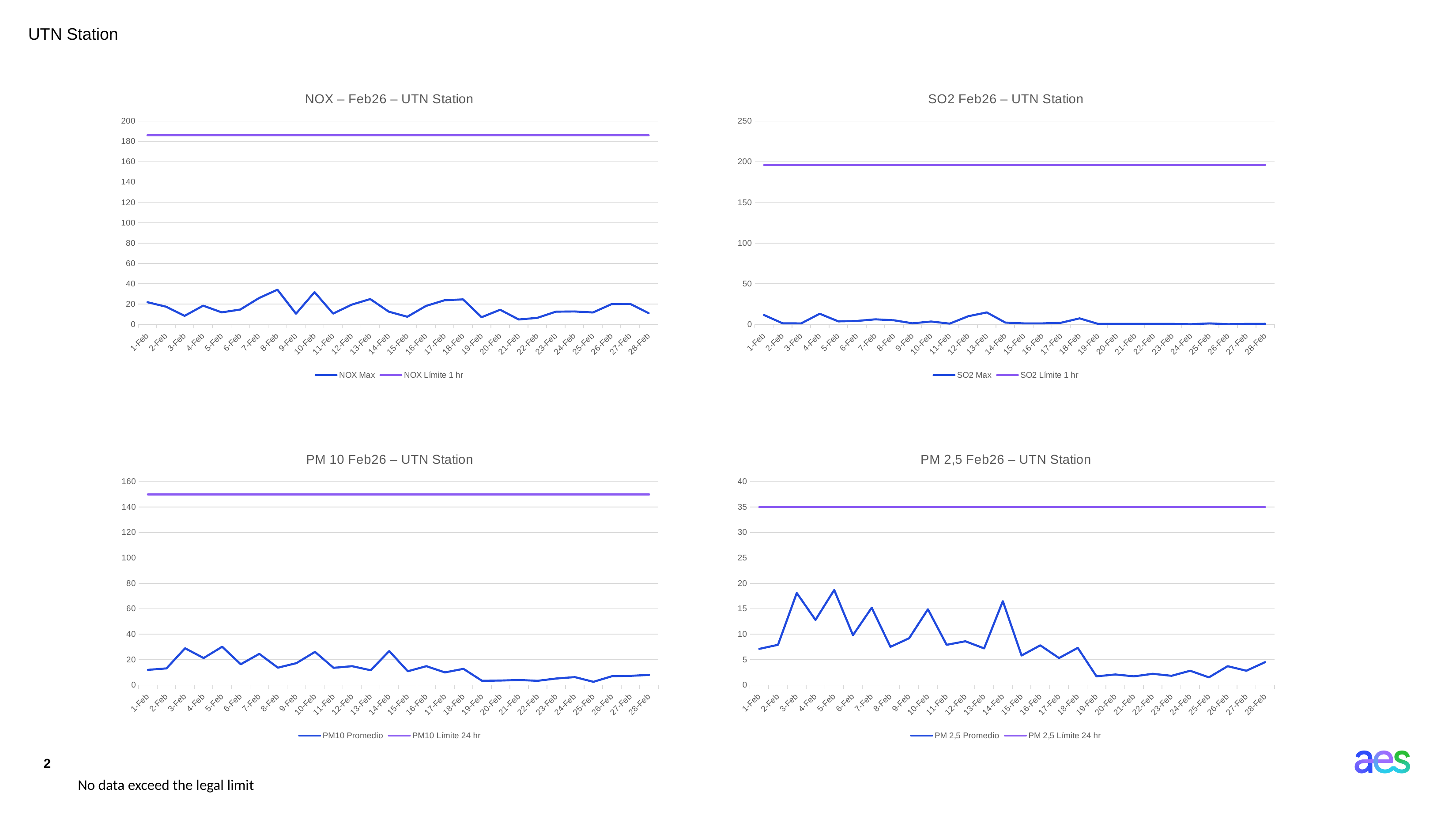
In the "PM 2,5 Feb26 – UTN Station" chart, is the PM 2,5 Promedio value on 20-Feb greater or less than 5? less What kind of chart is the "NOX – Feb26 – UTN Station" chart? line chart In the "PM 10 Feb26 – UTN Station" chart, which is larger, the PM10 Promedio value on 14-Feb or on 20-Feb? 14-Feb In the "NOX – Feb26 – UTN Station" chart, is the NOX Max value on 8-Feb greater or less than 20? greater In the "SO2 Feb26 – UTN Station" chart, is the SO2 Max value on 1-Feb greater or less than 50? less In the "PM 2,5 Feb26 – UTN Station" chart, which is larger, the PM 2,5 Promedio value on 3-Feb or on 4-Feb? 3-Feb In the "PM 2,5 Feb26 – UTN Station" chart, what is the value of the PM 2,5 Límite 24 hr line? 35 What are the two legend entries of the "PM 10 Feb26 – UTN Station" chart? PM10 Promedio and PM10 Límite 24 hr How many dates are plotted along the x axis of the "PM 10 Feb26 – UTN Station" chart? 28 How many series does the legend of the "SO2 Feb26 – UTN Station" chart list? 2